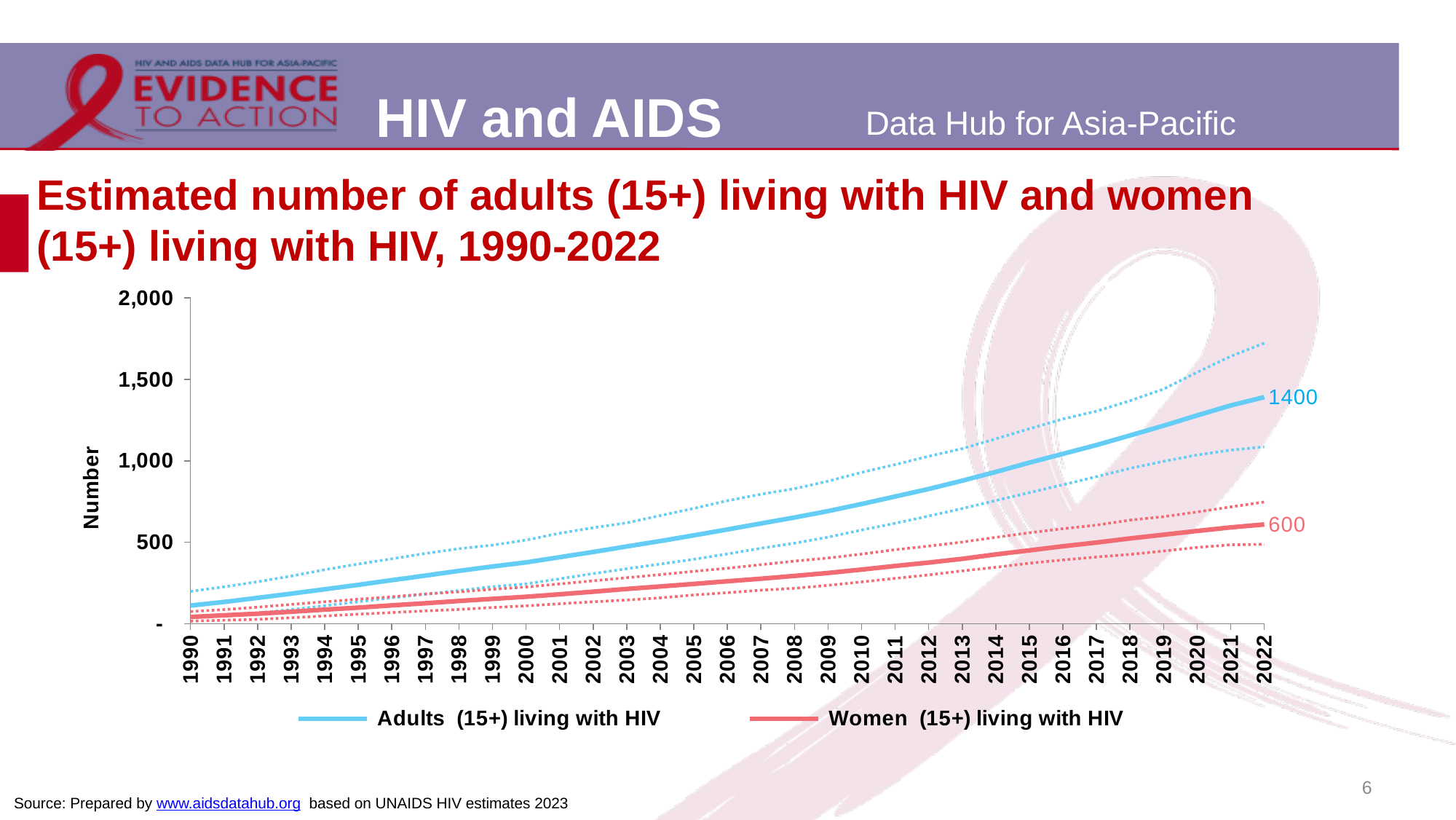
In 2022, which series has the larger value: adults (15+) living with HIV or women (15+) living with HIV? Adults (15+) living with HIV How many years are shown on the x axis of the chart? 33 Do the values for adults (15+) living with HIV rise or fall from 1990 to 2022? Rise What is the estimated number of women (15+) living with HIV in 2022? 600 Is the value for adults (15+) living with HIV in 2018 greater or less than 1,000? greater What kind of chart is shown on the slide? Line chart Is the value for adults (15+) living with HIV in 2010 greater or less than 1,000? less How many series does the legend list? 2 What is the difference between the 2022 values for adults (15+) living with HIV and women (15+) living with HIV? 800 Is the value for women (15+) living with HIV in 2000 greater or less than 500? less What is the label of the y axis of the chart? Number What is the estimated number of adults (15+) living with HIV in 2022? 1400